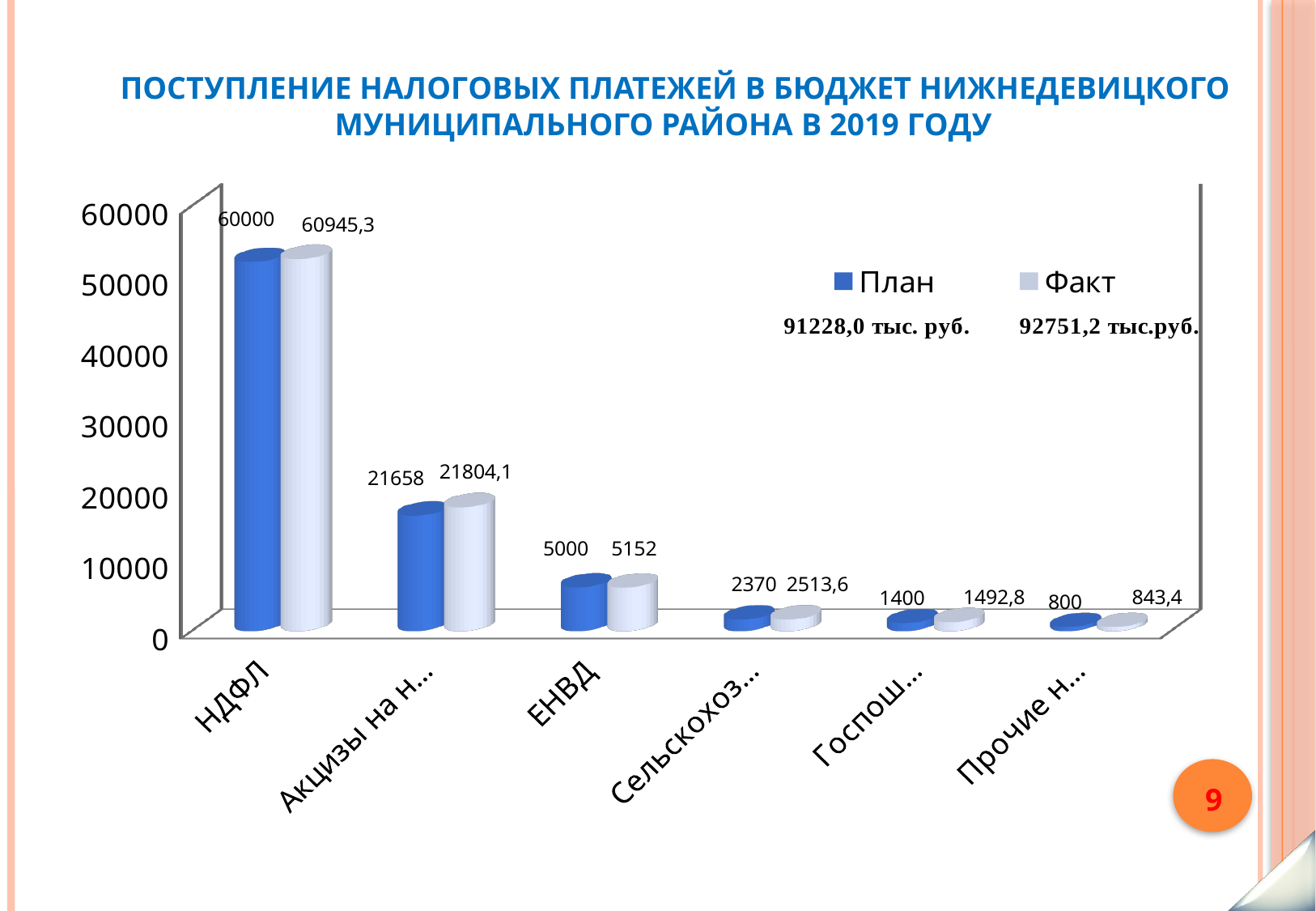
What is the difference between the Факт and План values for ЕНВД? 152 What is the План value for НДФЛ? 60000 Which category has the lowest План value? Прочие н... How many series does the legend list? 2 How many categories are shown on the x axis? 6 What is the Факт value for НДФЛ? 60945,3 What kind of chart is shown on the slide? bar chart Which is larger for ЕНВД, the План value or the Факт value? Факт What is the difference between the Факт and План values for НДФЛ? 945,3 What is the План value for the category labelled Госпош...? 1400 What is the Факт value for ЕНВД? 5152 Which category has the highest Факт value? НДФЛ